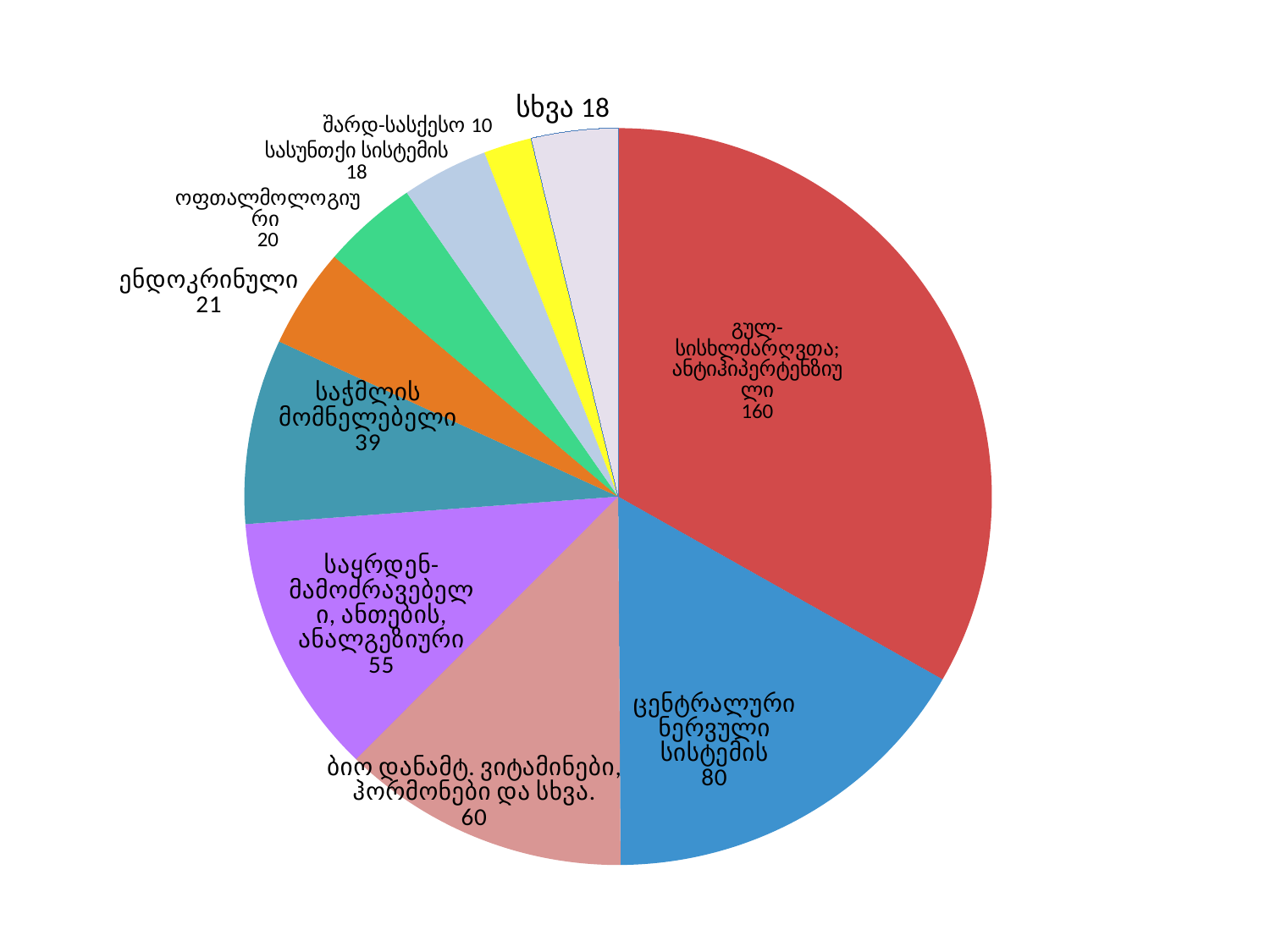
What is the value for the ოფთალმოლოგიური slice? 20 Which is larger: the value for ბიო დანამტ. ვიტამინები, ჰორმონები და სხვა. or the value for საყრდენ-მამოძრავებელი, ანთების, ანალგეზიური? ბიო დანამტ. ვიტამინები, ჰორმონები და სხვა. What is the value for the ენდოკრინული slice? 21 What is the value for the ცენტრალური ნერვული სისტემის slice? 80 What is the value for the შარდ-სასქესო slice? 10 Which category has the smallest slice of the pie? შარდ-სასქესო What kind of chart is shown on the slide? pie chart What is the value for the საჭმლის მომნელებელი slice? 39 What is the difference between the გულ-სისხლძარღვთა; ანტიჰიპერტენზიული value and the ცენტრალური ნერვული სისტემის value? 80 How many slices does the pie chart have? 10 Which category has the largest slice of the pie? გულ-სისხლძარღვთა; ანტიჰიპერტენზიული What is the difference between the სასუნთქი სისტემის value and the შარდ-სასქესო value? 8